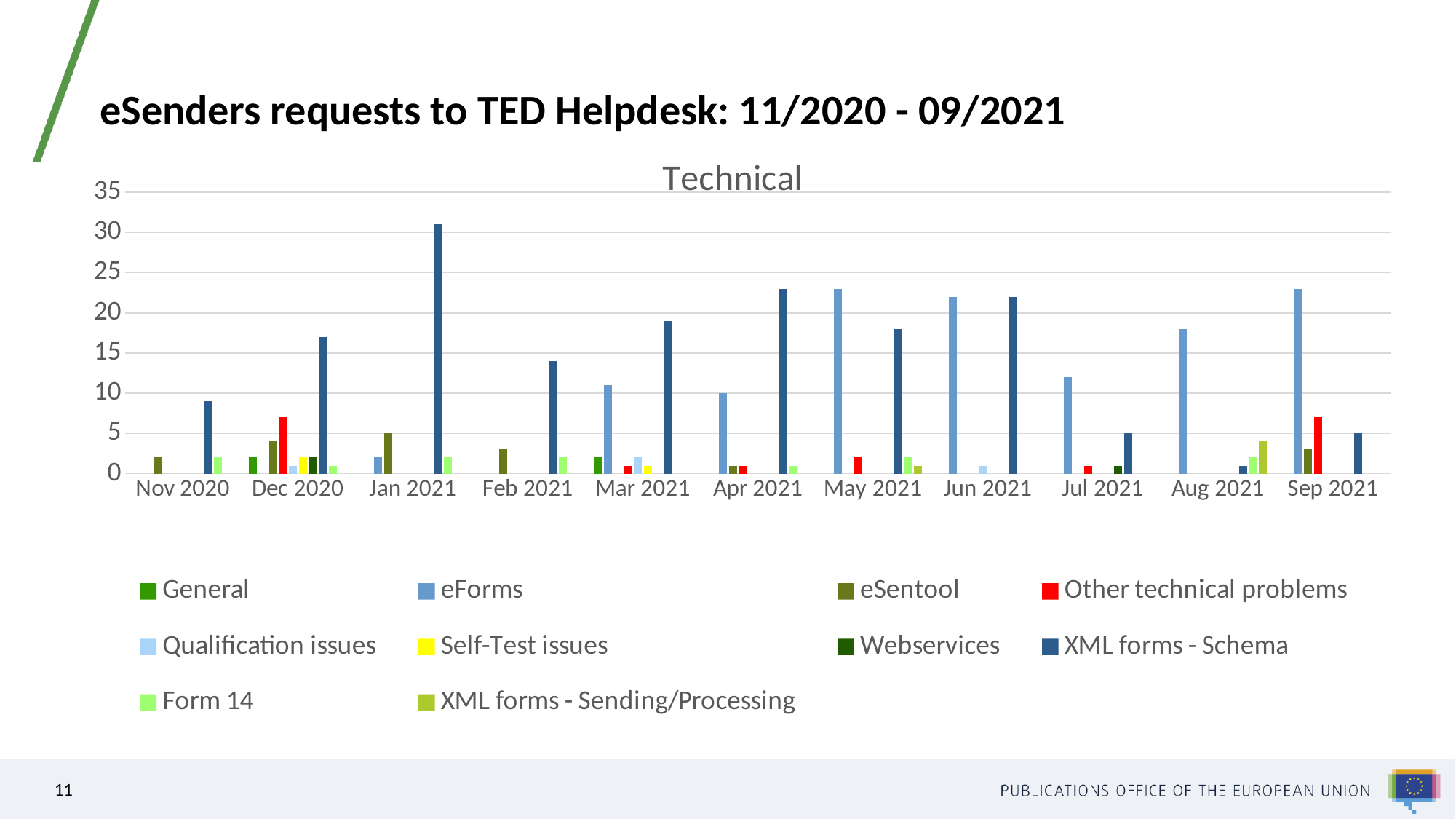
Is the value for eForms in May 2021 greater or less than 20? greater In which month does the XML forms - Schema series reach its highest value? Jan 2021 What is the value for XML forms - Schema in Jul 2021? 5 What is the value for eForms in Apr 2021? 10 How many series does the legend list? 10 Is the value for XML forms - Schema in Feb 2021 greater or less than 15? less In Dec 2020, which is larger: Other technical problems or eSentool? Other technical problems Is the value for eForms in Jul 2021 greater or less than 10? greater What kind of chart is shown on the slide? bar chart What is the title of the chart? Technical How many months are shown on the x axis? 11